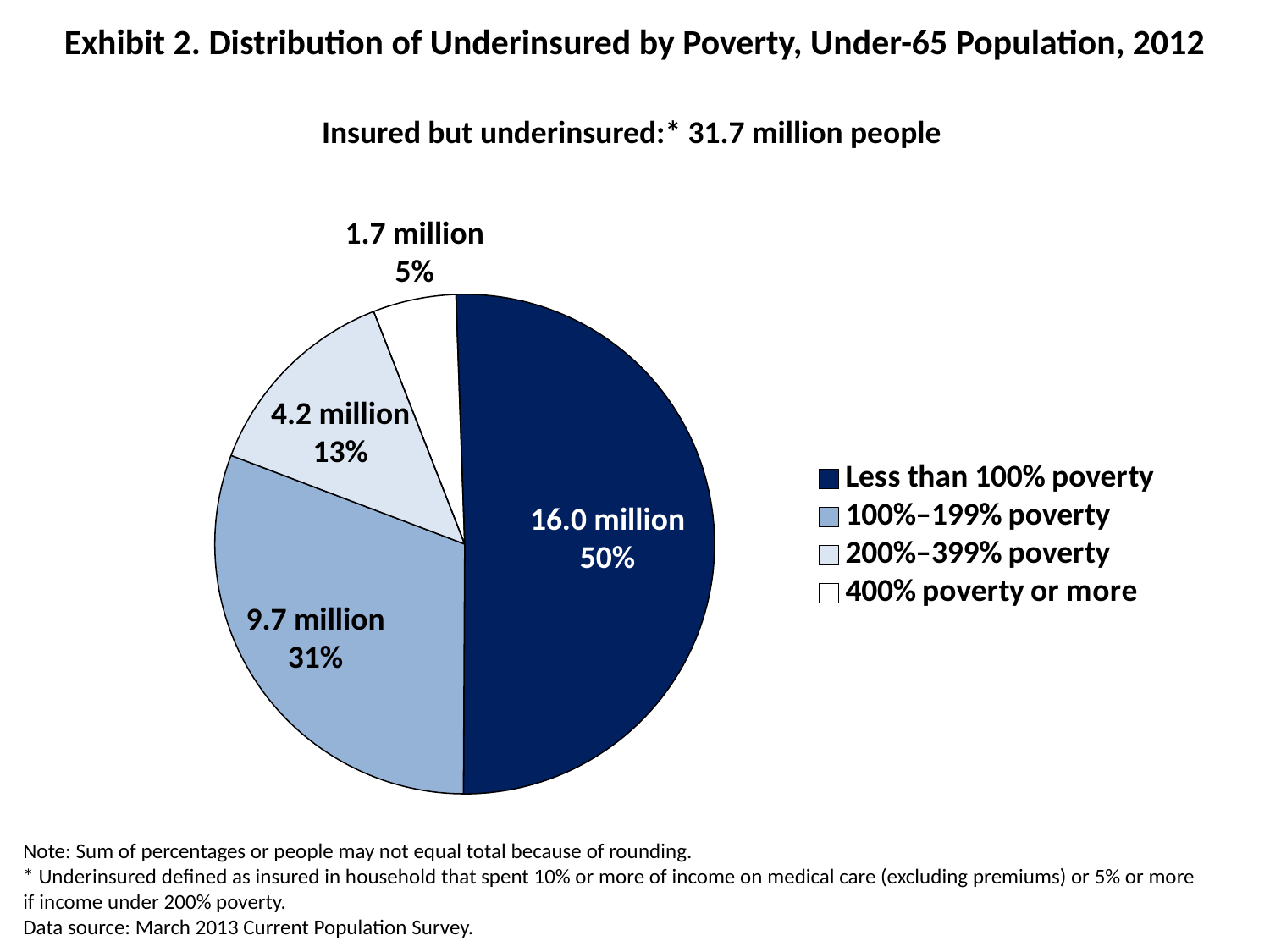
What share of the pie does the '400% poverty or more' slice represent? 5% Which slice is larger: '200%–399% poverty' or '400% poverty or more'? 200%–399% poverty How many people are in the '200%–399% poverty' slice? 4.2 million How many people are in the 'Less than 100% poverty' slice? 16.0 million Which poverty category has the largest slice? Less than 100% poverty How many slices does the pie chart have? 4 Which poverty category has the smallest slice? 400% poverty or more How many categories does the legend list? 4 What is the difference in millions of people between the 'Less than 100% poverty' slice and the '100%–199% poverty' slice? 6.3 million What kind of chart is shown on the slide? Pie chart What is the total number of insured but underinsured people stated on the slide? 31.7 million people What share of the pie does the '100%–199% poverty' slice represent? 31%